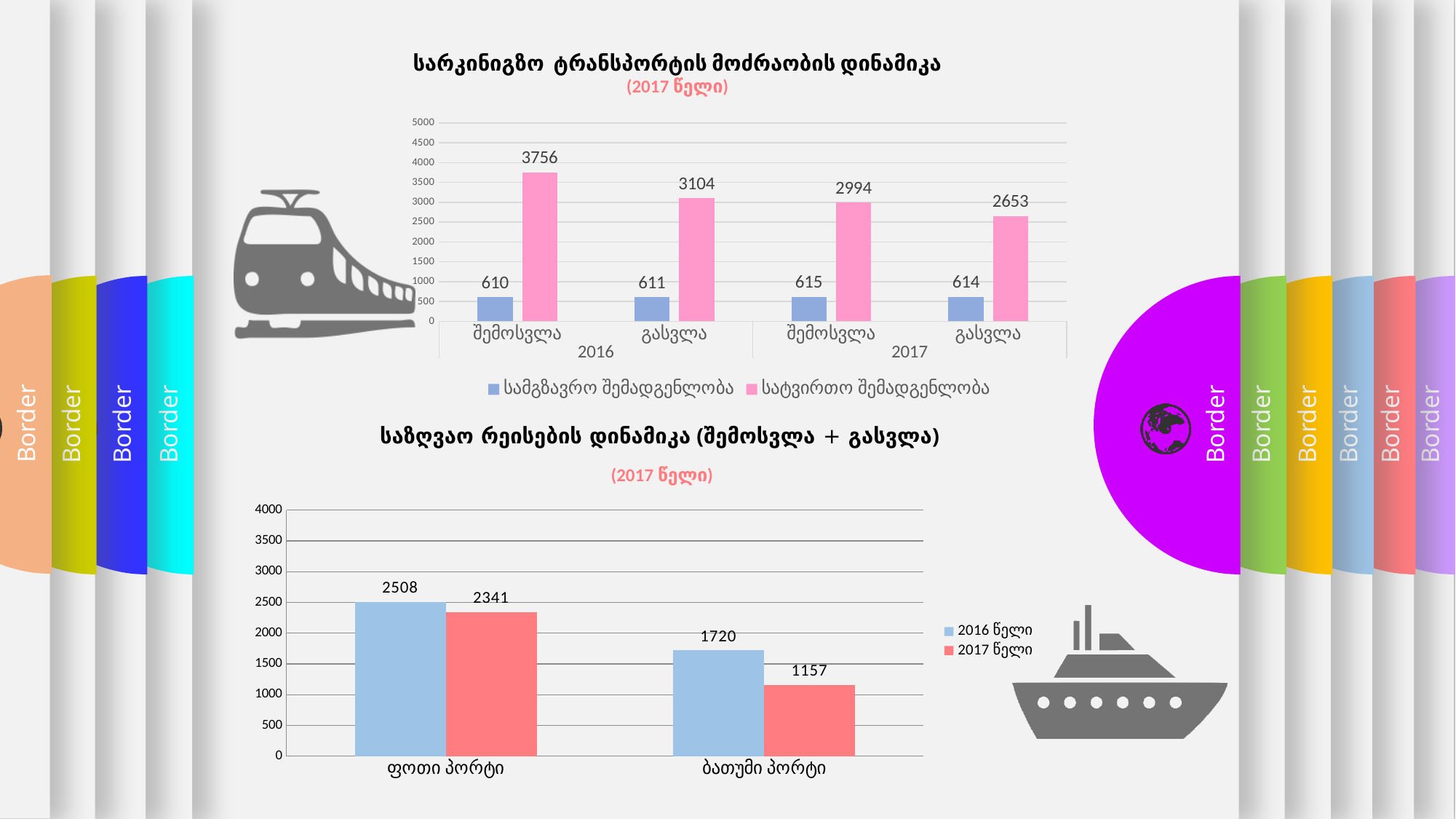
What type of chart is the bottom chart (საზღვაო რეისების დინამიკა)? bar chart In the bottom chart (საზღვაო რეისების დინამიკა), how many port categories are shown on the x axis? 2 In the bottom chart (საზღვაო რეისების დინამიკა), what is the value for ბათუმი პორტი in 2017 წელი? 1157 In the top chart (railway transport), which category has the lowest value for სატვირთო შემადგენლობა? გასვლა 2017 In the top chart (railway transport), what is the value of სამგზავრო შემადგენლობა for გასვლა in 2017? 614 In the bottom chart (საზღვაო რეისების დინამიკა), what is the difference between the 2016 წელი and 2017 წელი values for ფოთი პორტი? 167 In the top chart (railway transport), what is the difference between სატვირთო შემადგენლობა for შემოსვლა 2016 and შემოსვლა 2017? 762 In the top chart (railway transport), does the value of სატვირთო შემადგენლობა for გასვლა 2017 rise or fall compared with გასვლა 2016? fall In the top chart (railway transport), which category has the highest value for სატვირთო შემადგენლობა? შემოსვლა 2016 In the top chart (railway transport, სარკინიგზო ტრანსპორტის მოძრაობის დინამიკა), what is the value of სატვირთო შემადგენლობა for შემოსვლა in 2016? 3756 In the bottom chart (საზღვაო რეისების დინამიკა), which is larger: the 2016 წელი value for ბათუმი პორტი or the 2017 წელი value for ფოთი პორტი? 2017 წელი value for ფოთი პორტი In the top chart (railway transport), how many series does the legend list? 2